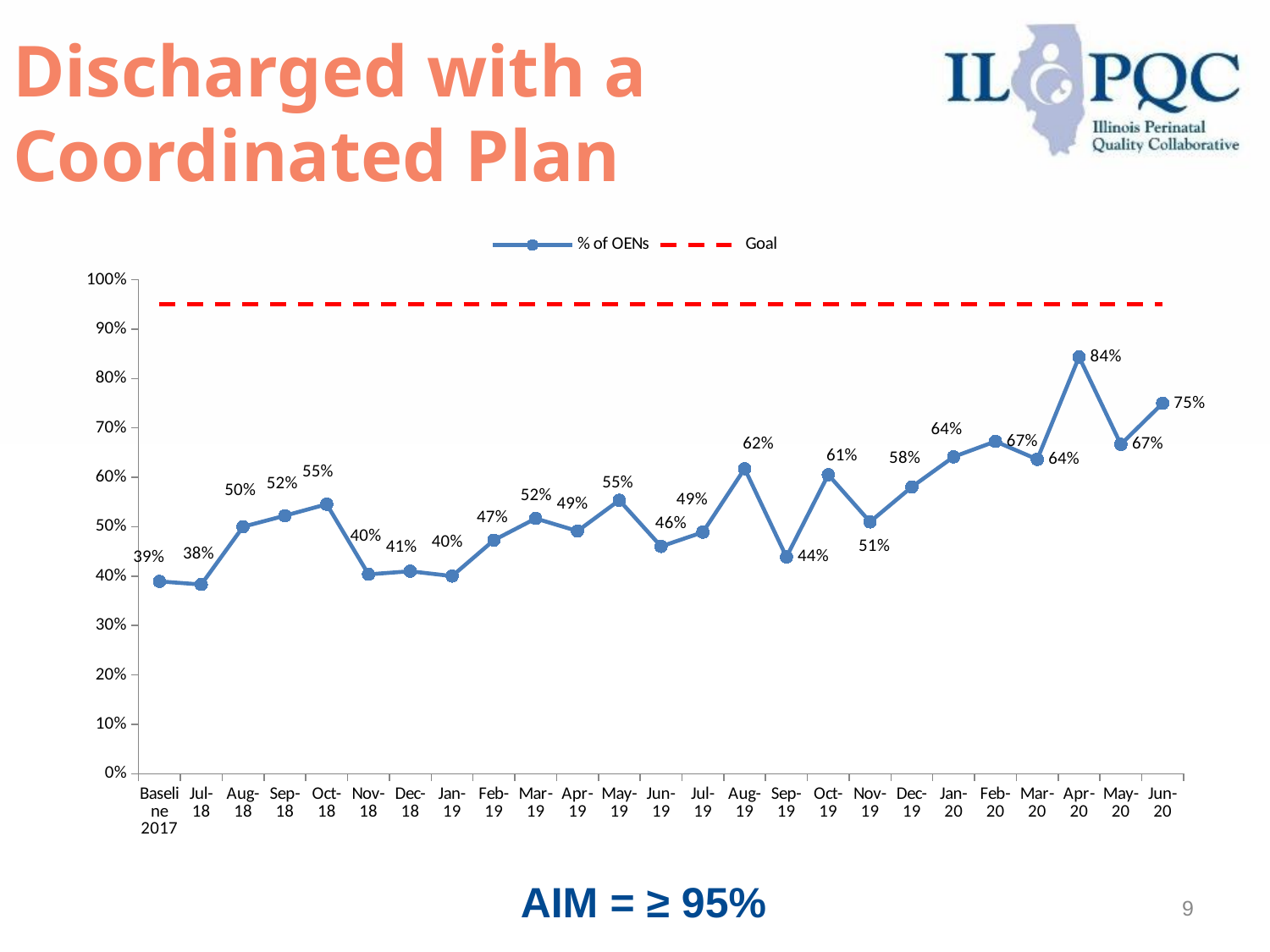
What type of chart is shown on the slide? Line chart What is the % of OENs value for the Baseline 2017 point? 39% Which month has the highest % of OENs? Apr-20 What is the difference in % of OENs between Apr-20 and Jul-18? 46% Overall, does the % of OENs rise or fall from Baseline 2017 to Jun-20? Rise What is the % of OENs value for Jun-20? 75% How many data points are plotted on the % of OENs line? 25 Which is larger, the % of OENs for Aug-19 or for Sep-19? Aug-19 How many series does the legend list? 2 What is the % of OENs value for Apr-20? 84% What is the AIM goal stated below the chart? ≥ 95% Which month has the lowest % of OENs? Jul-18